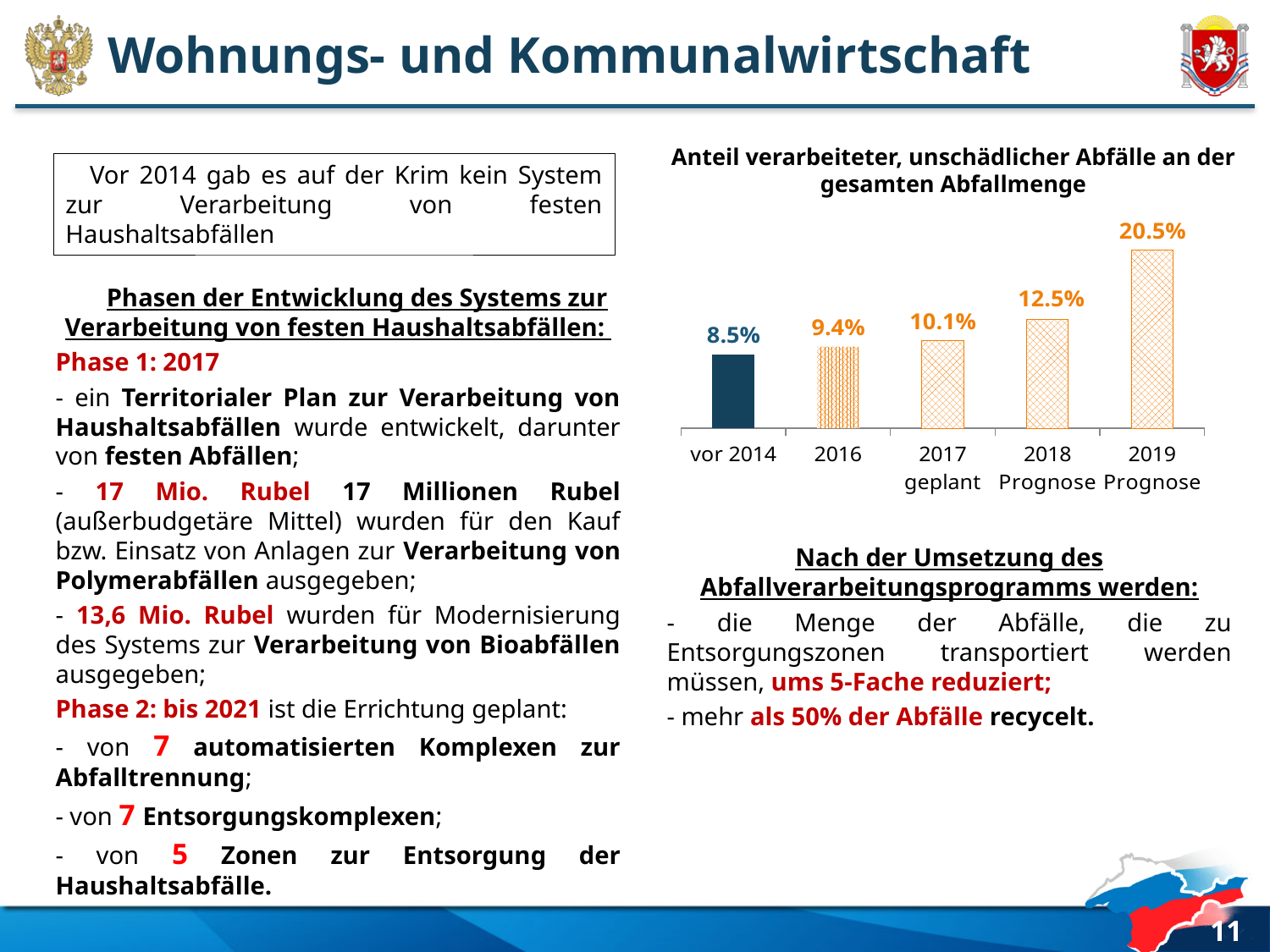
Which category has the lowest value in the chart? vor 2014 What is the difference between the values for 2019 Prognose and 2018 Prognose? 8.0% What is the title of the chart? Anteil verarbeiteter, unschädlicher Abfälle an der gesamten Abfallmenge What is the value for 2018 Prognose in the chart? 12.5% Do the values rise or fall from left to right along the x axis? rise How many categories are shown on the x axis of the chart? 5 What is the difference between the values for 2017 geplant and vor 2014? 1.6% Which category has the highest value in the chart? 2019 Prognose Which is larger, the value for 2017 geplant or the value for 2016? 2017 geplant What is the value for 'vor 2014' in the chart? 8.5% What kind of chart is shown on the slide? bar chart What is the value for 2016 in the chart? 9.4%